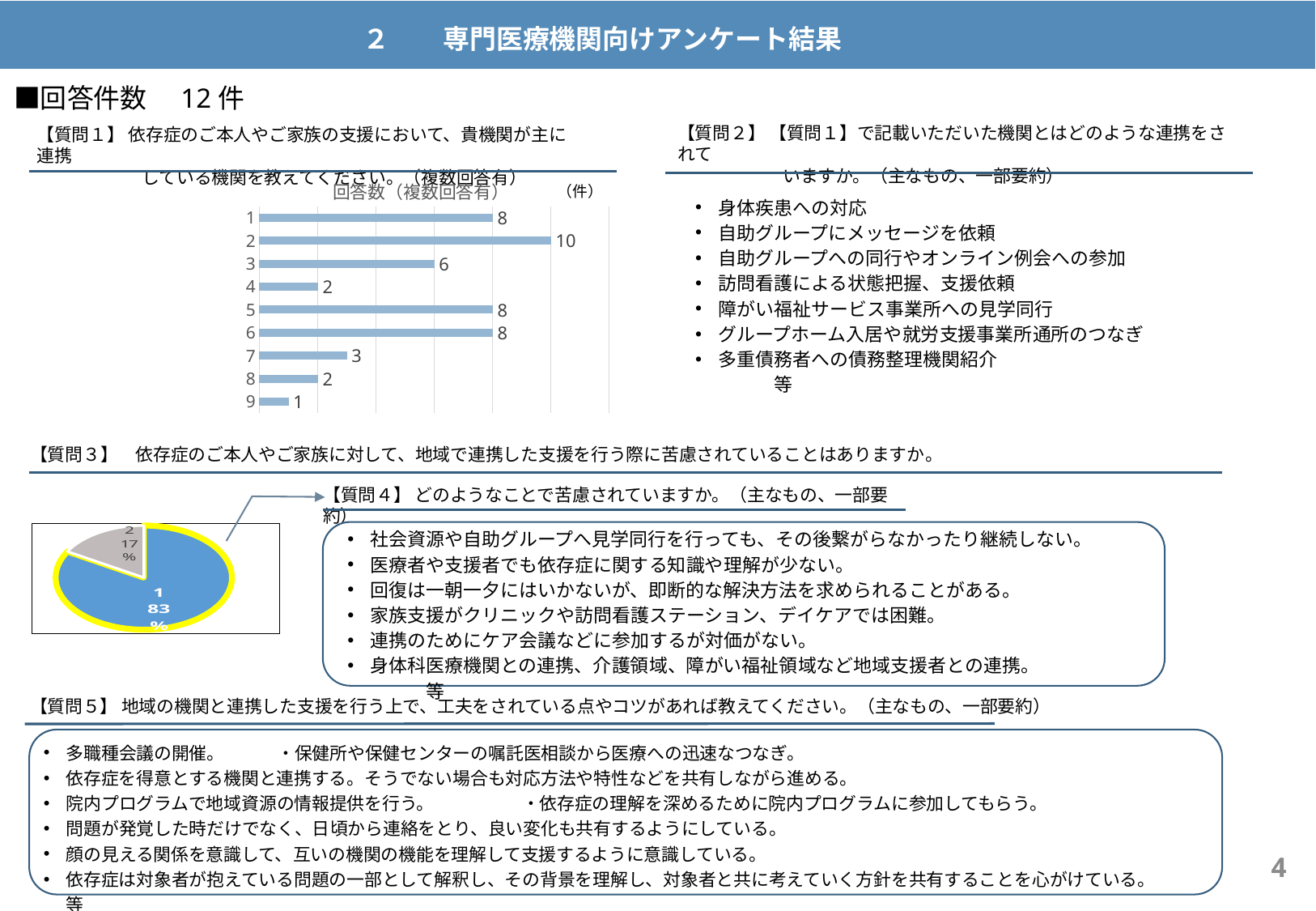
In the bar chart titled 回答数（複数回答有）, what unit is shown next to the chart? 件 In the bar chart titled 回答数（複数回答有）, what is the value for category 2? 10 In the bar chart titled 回答数（複数回答有）, which category has the lowest value? 9 In the pie chart under 【質問３】, what share does slice 2 have? 17% In the bar chart titled 回答数（複数回答有）, which is larger, the value for category 1 or the value for category 4? category 1 In the pie chart under 【質問３】, what share does slice 1 have? 83% In the bar chart titled 回答数（複数回答有）, which category has the highest value? 2 What kind of chart is shown under 【質問３】 on the left of the slide? pie chart In the bar chart titled 回答数（複数回答有）, what is the difference between the values for category 2 and category 3? 4 What kind of chart is the chart titled 回答数（複数回答有）? bar chart In the bar chart titled 回答数（複数回答有）, how many categories are plotted? 9 In the bar chart titled 回答数（複数回答有）, what is the value for category 7? 3